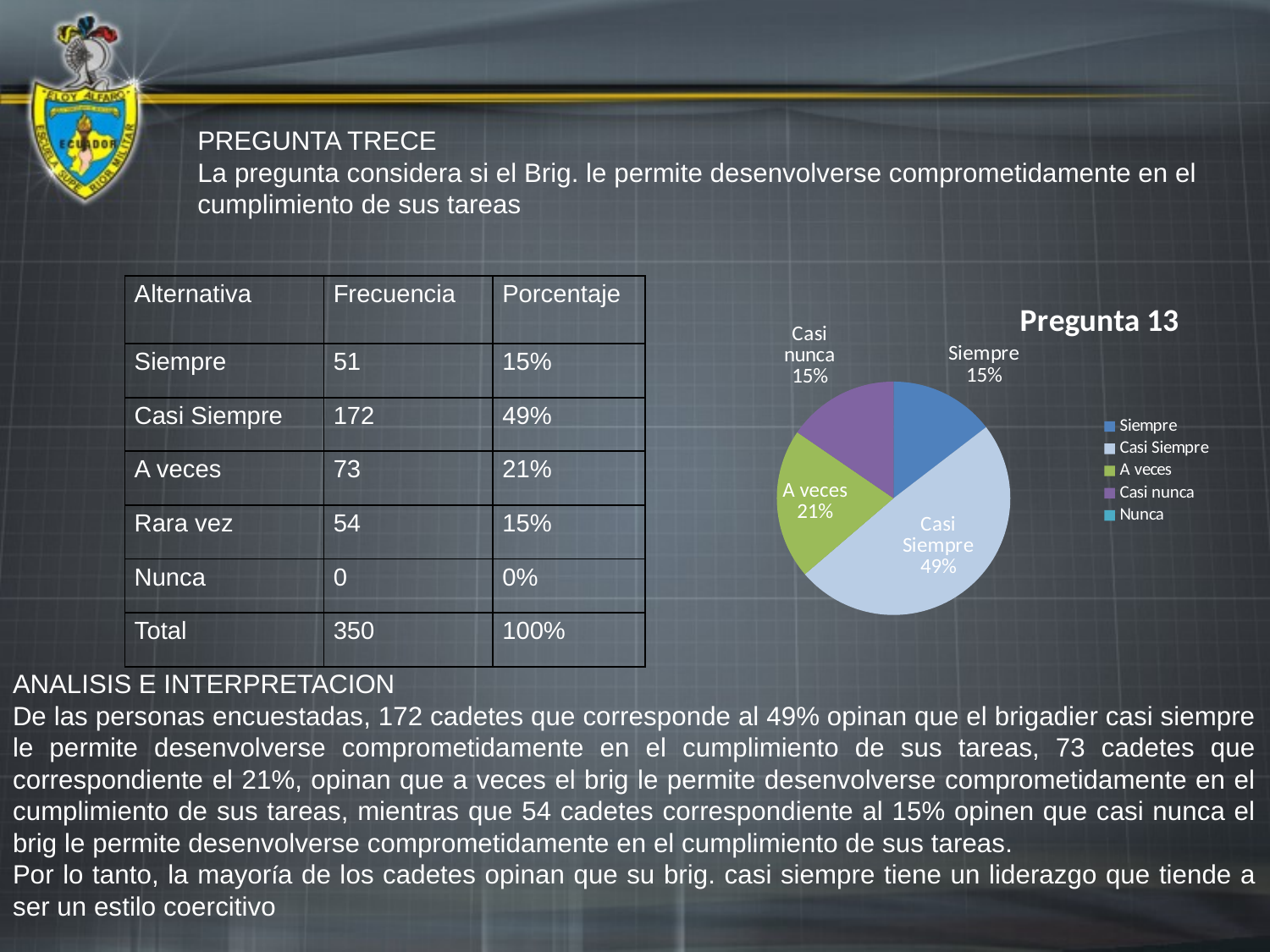
Which legend entry has no visible slice in the pie? Nunca What percentage does the 'Siempre' slice show? 15% Which category has the largest slice of the pie? Casi Siempre What is the title of the chart? Pregunta 13 What is the difference in percentage points between the 'Casi Siempre' slice and the 'A veces' slice? 28 How many entries does the chart's legend list? 5 What type of chart is shown on the slide? pie chart Which is larger, the 'A veces' slice or the 'Siempre' slice? A veces What is the difference in percentage points between the 'A veces' slice and the 'Casi nunca' slice? 6 What percentage does the 'Casi Siempre' slice show? 49% What percentage does the 'Casi nunca' slice show? 15% What percentage does the 'A veces' slice show? 21%